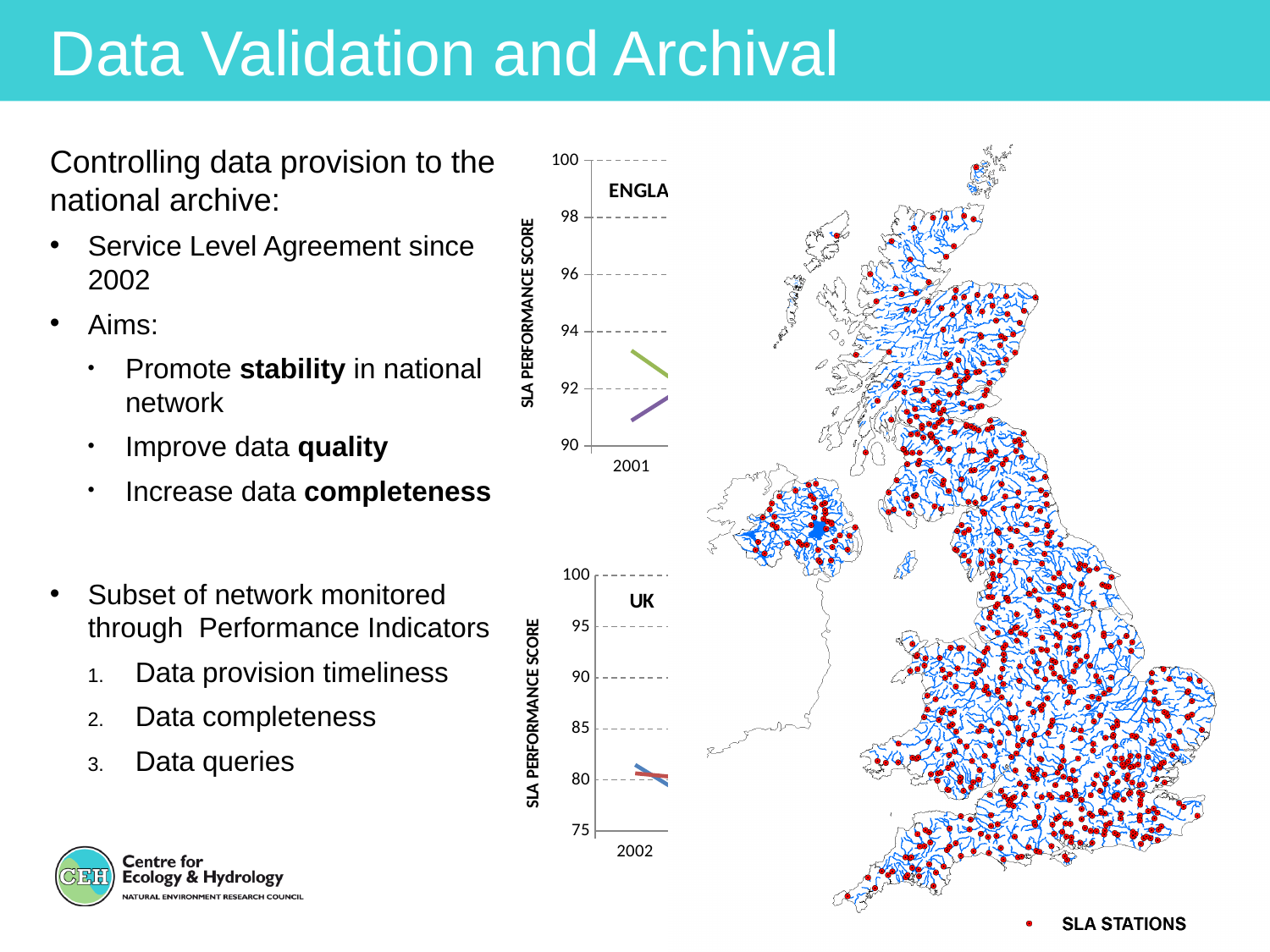
In the top chart, does the purple line rise or fall moving right from 2001? rise In the bottom chart (UK), is the value of the red line at 2002 greater or less than 85? less In the top chart, is the value of the green line at 2001 greater or less than 92? greater In the top chart, is the value of the green line at 2001 greater or less than 94? less What is the y-axis label of the bottom chart (UK)? SLA PERFORMANCE SCORE In the top chart, which line has the higher value at 2001, the green line or the purple line? green line What is the title shown inside the bottom chart? UK In the top chart, does the green line rise or fall moving right from 2001? fall What kind of chart is the bottom chart (labelled UK) on the slide? line chart What kind of chart is the top chart (labelled ENGLA...) on the slide? line chart